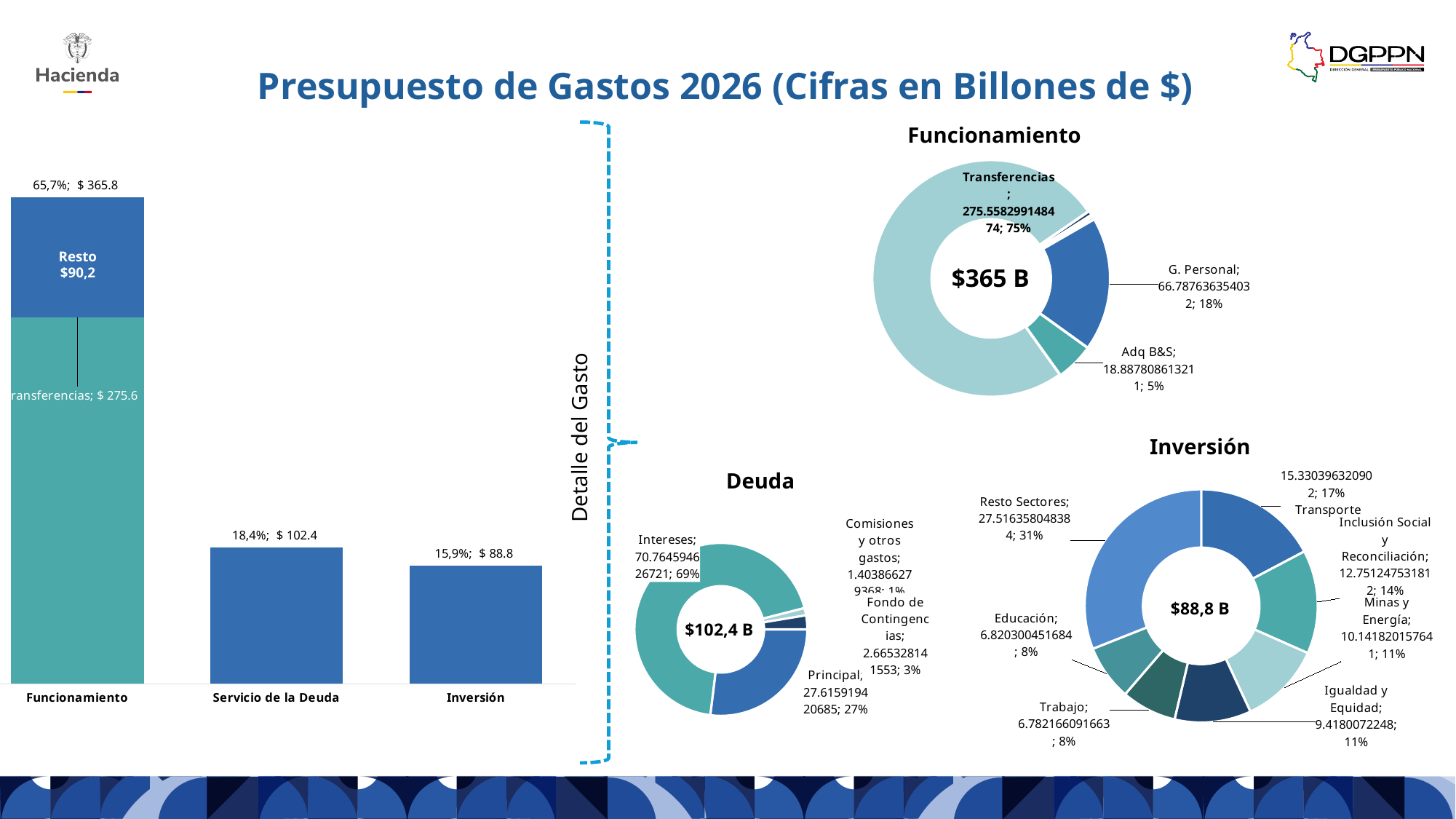
In the Inversión donut chart, how many slices are there? 7 In the bar chart on the left, what value is labelled for the Resto segment of the Funcionamiento bar? $90,2 In the bar chart on the left, how many categories are shown on the x axis? 3 In the bar chart on the left, which category has the lowest value? Inversión What kind of chart is the chart on the left of the slide? Bar chart In the Inversión donut chart, which slice has the largest share? Resto Sectores In the bar chart on the left, which category has the highest value? Funcionamiento In the Deuda donut chart, what percentage share is labelled for Intereses? 69% In the Inversión donut chart, which is larger: Transporte or Educación? Transporte In the bar chart on the left, what is the difference between the values for Servicio de la Deuda ($ 102.4) and Inversión ($ 88.8)? $ 13.6 In the bar chart on the left, what value is labelled for Servicio de la Deuda? $ 102.4 In the Funcionamiento donut chart, what percentage share is labelled for Transferencias? 75%